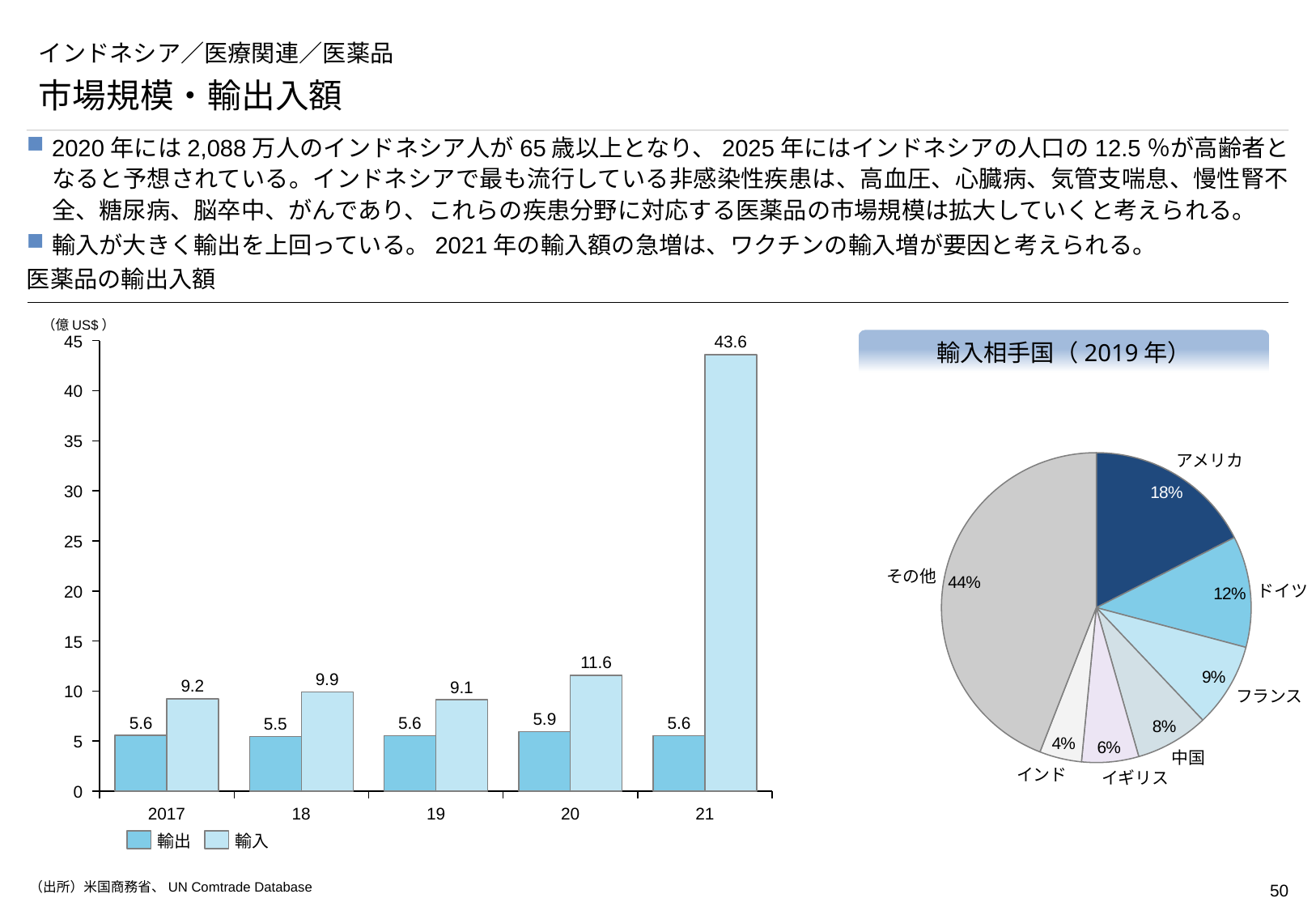
In the bar chart on the left (医薬品の輸出入額), what is the value of 輸入 for 2021? 43.6 What kind of chart is the chart on the right (輸入相手国 (2019年))? pie chart In the bar chart on the left, what is the value of 輸出 for 2017? 5.6 In the bar chart on the left, what is the difference between 輸入 and 輸出 in 2020? 5.7 In the pie chart on the right, what is the difference between the shares of ドイツ and フランス? 3% In the bar chart on the left, what is the value of 輸入 for 2018? 9.9 In the pie chart on the right, which country has the smallest share? インド In the bar chart on the left, which is larger in 2019, 輸出 or 輸入? 輸入 In the bar chart on the left, how many series does the legend list? 2 In the bar chart on the left, how many years are shown on the x axis? 5 In the bar chart on the left, which year has the highest 輸入 value? 2021 In the pie chart on the right, what share does アメリカ have? 18%